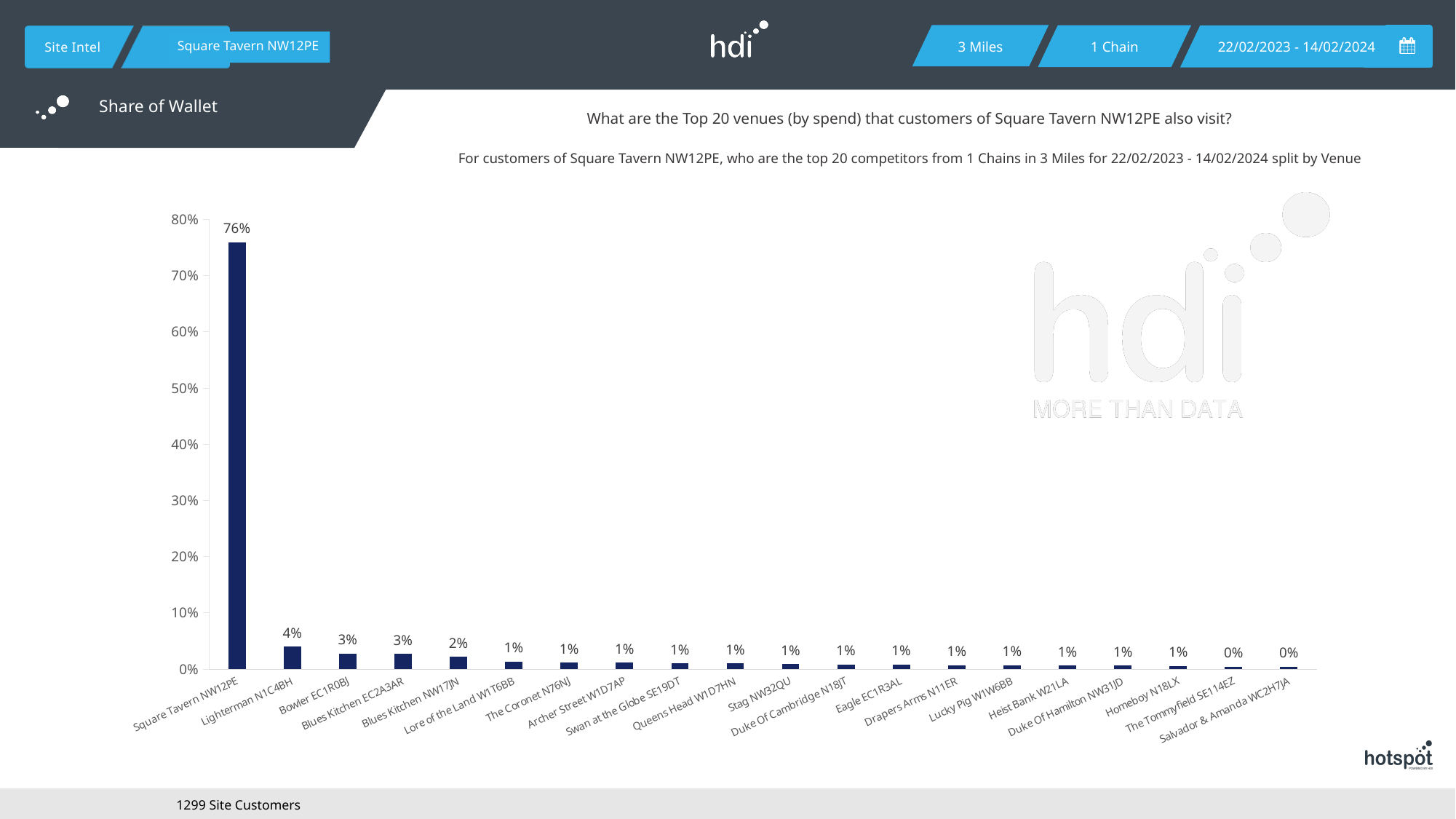
What is the value for Lighterman N1C4BH? 4% What share of wallet is shown for Square Tavern NW12PE? 76% What is the difference between the values for Square Tavern NW12PE and Lighterman N1C4BH? 72% What is the value shown for The Tommyfield SE114EZ? 0% Which has the larger value, Lighterman N1C4BH or Bowler EC1R0BJ? Lighterman N1C4BH Is the value for Square Tavern NW12PE greater or less than 70%? greater Do the values rise or fall moving from left to right along the x axis? Fall What is the value for Bowler EC1R0BJ? 3% How many venues are plotted in the chart? 20 What kind of chart is shown on the slide? Bar chart Which venue has the highest value in the chart? Square Tavern NW12PE What is the value for Blues Kitchen NW17JN? 2%